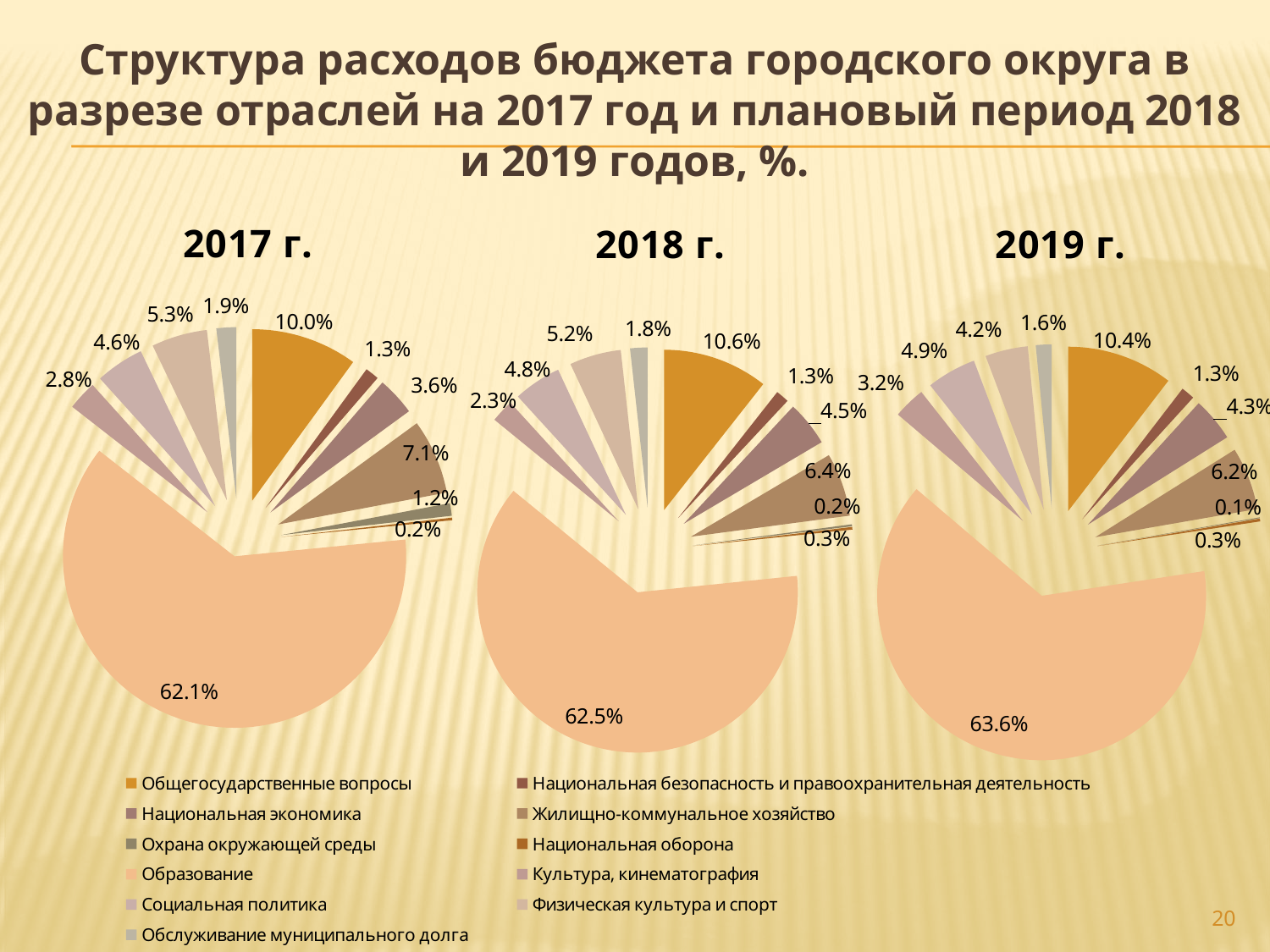
Does the share of Образование rise or fall from the 2017 г. chart to the 2019 г. chart? Rises In the 2019 г. pie chart, what share is shown for Культура, кинематография? 3.2% How many pie charts are shown on the slide? 3 By how many percentage points does the Образование share in the 2019 г. chart exceed that in the 2017 г. chart? 1.5 In the 2017 г. pie chart, what share is shown for Образование? 62.1% In the 2017 г. pie chart, what share is shown for Физическая культура и спорт? 5.3% In the 2018 г. pie chart, what share is shown for Общегосударственные вопросы? 10.6% In the 2019 г. pie chart, what share is shown for Образование? 63.6% How many categories does the legend list? 11 Is the Жилищно-коммунальное хозяйство share larger in the 2017 г. chart or the 2018 г. chart? 2017 г. In the 2018 г. pie chart, which category has the largest slice? Образование What kind of chart is used on this slide to show the budget expenditure structure? Pie chart